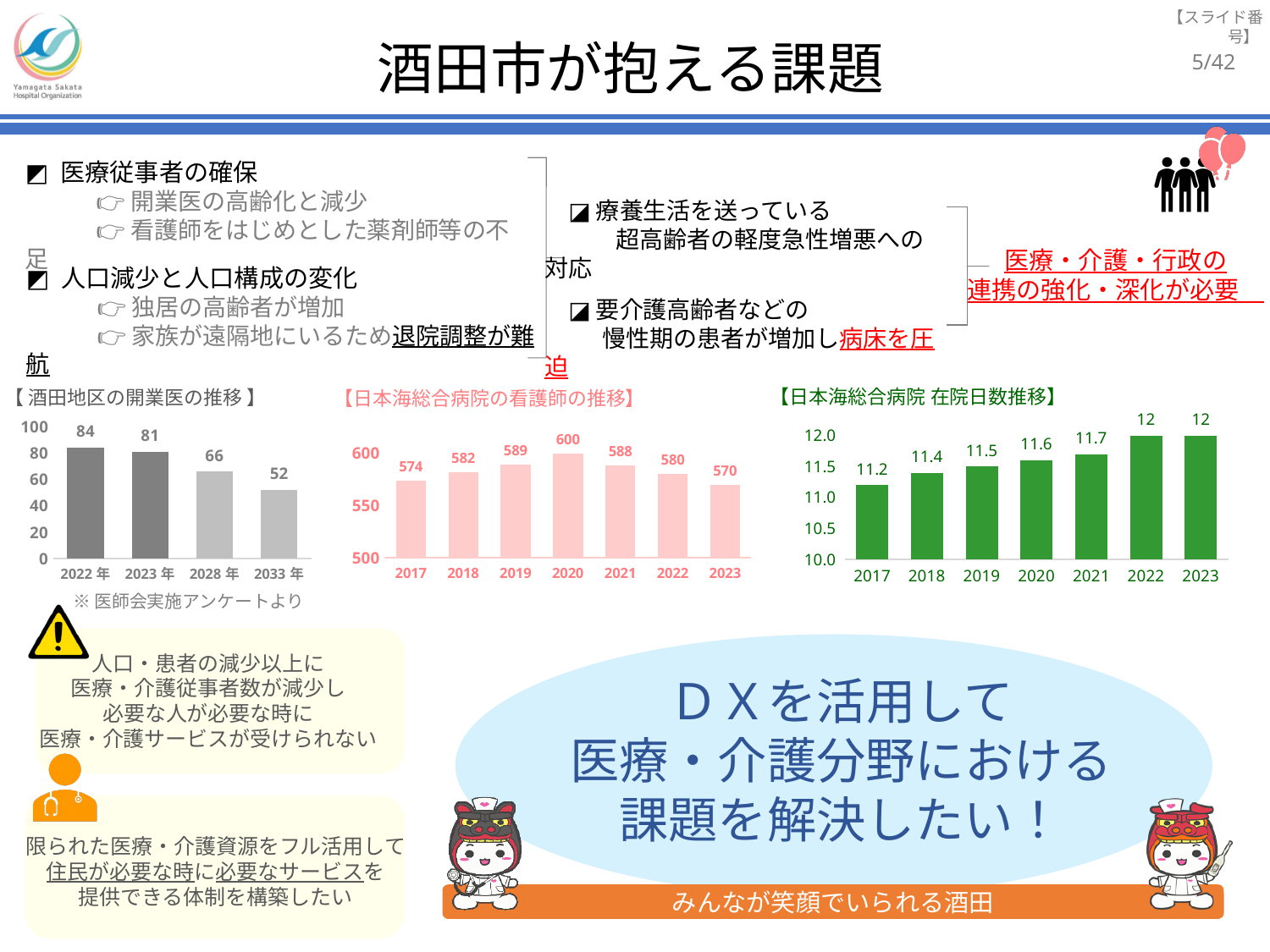
In the chart titled 日本海総合病院 在院日数推移, what is the value for 2019? 11.5 In the chart titled 酒田地区の開業医の推移, how many bars are plotted? 4 In the chart titled 酒田地区の開業医の推移, what is the difference between the values for 2022年 and 2033年? 32 In the chart titled 日本海総合病院の看護師の推移, what is the difference between the values for 2020 and 2023? 30 In the chart titled 日本海総合病院の看護師の推移, which year has the highest value? 2020 In the chart titled 酒田地区の開業医の推移, which category has the lowest value? 2033年 In the chart titled 日本海総合病院 在院日数推移, which is larger, the value for 2018 or the value for 2021? 2021 In the chart titled 日本海総合病院の看護師の推移, what is the value for 2020? 600 In the chart titled 日本海総合病院の看護師の推移, which year has the lowest value? 2023 In the chart titled 日本海総合病院 在院日数推移, do the values rise or fall from 2017 to 2023? rise What kind of chart is the one titled 日本海総合病院 在院日数推移? bar chart In the chart titled 酒田地区の開業医の推移, what is the value for 2022年? 84